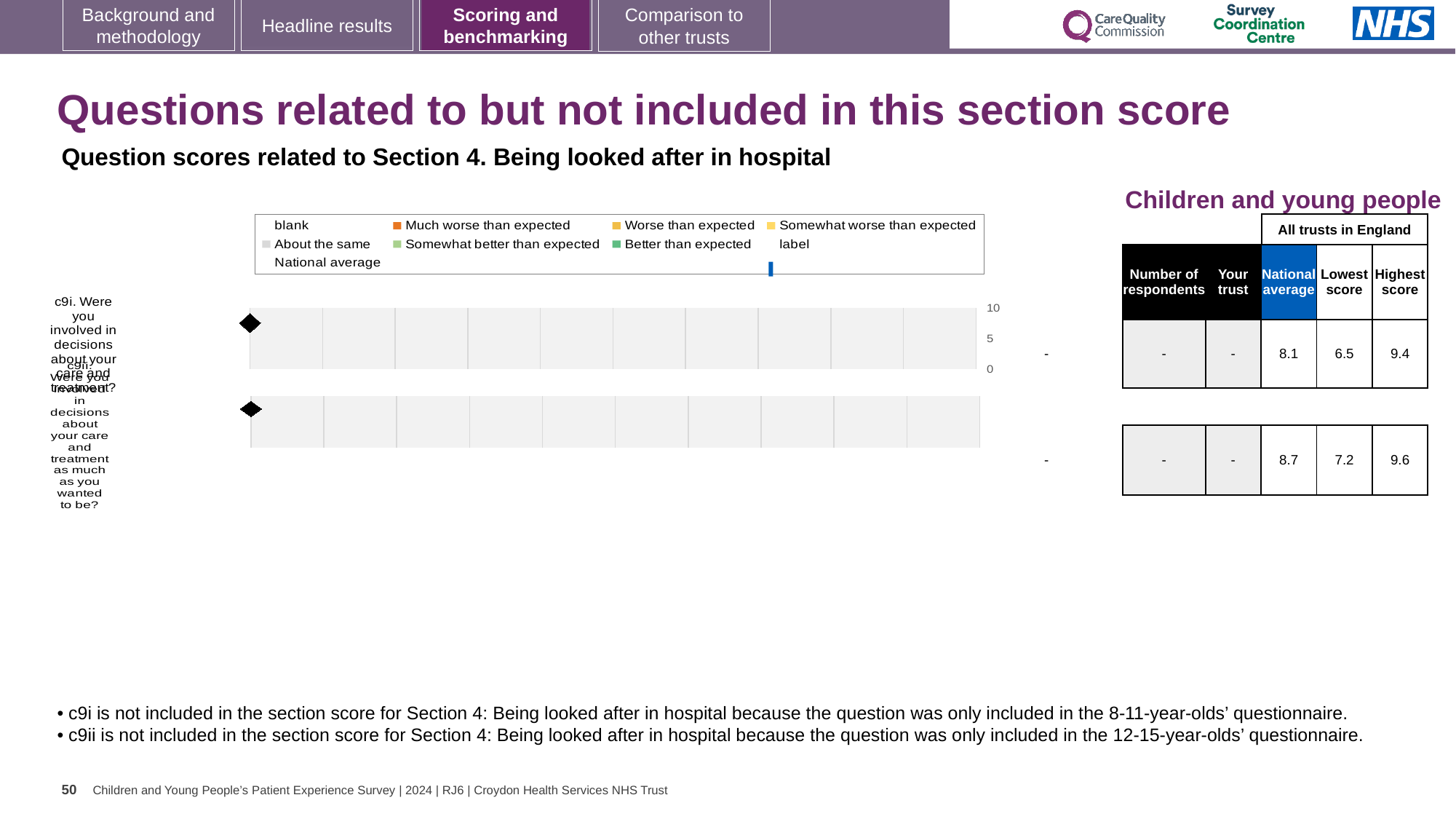
In the table, what is the highest score for c9ii? 9.6 What is the highest value shown on the chart's axis? 10 Which question is listed first (top) on the chart? c9i. Were you involved in decisions about your care and treatment? How many question categories are plotted on the chart? 2 What kind of chart is shown on the slide? bar chart In the table, what is the highest score for c9i? 9.4 In the table, what is the lowest score for c9i? 6.5 In the table, what is the national average for c9ii? 8.7 In the table, what is the difference between the highest and lowest score for c9i? 2.9 In the table, what is the national average for c9i? 8.1 In the table, which question has the higher national average, c9i or c9ii? c9ii In the table, what is the lowest score for c9ii? 7.2